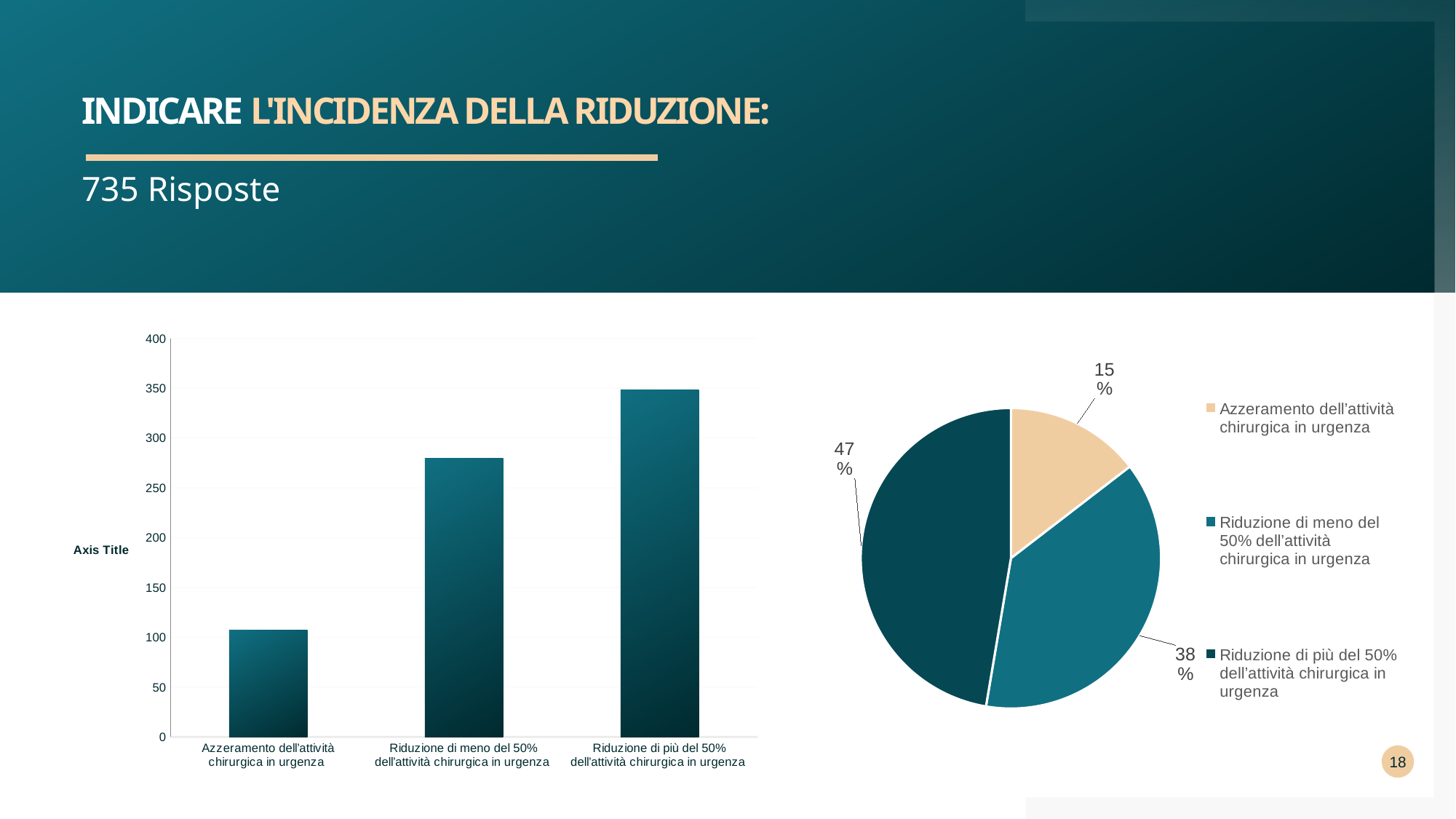
What kind of chart is on the right side of the slide? pie chart In the bar chart on the left, which category has the highest bar? Riduzione di più del 50% dell'attività chirurgica in urgenza What kind of chart is on the left side of the slide? bar chart In the pie chart on the right, what share is shown for Riduzione di più del 50% dell'attività chirurgica in urgenza? 47% In the pie chart on the right, how many percentage points larger is the 47% slice than the 38% slice? 9 In the bar chart on the left, how many categories are shown? 3 In the bar chart on the left, is the value for Riduzione di più del 50% dell'attività chirurgica in urgenza greater or less than 300? greater In the bar chart on the left, is the value for Azzeramento dell'attività chirurgica in urgenza greater or less than 150? less In the bar chart on the left, which category has the lowest bar? Azzeramento dell'attività chirurgica in urgenza In the pie chart on the right, what share is shown for Azzeramento dell'attività chirurgica in urgenza? 15% In the bar chart on the left, is the value for Riduzione di meno del 50% dell'attività chirurgica in urgenza greater or less than 250? greater In the bar chart on the left, do the bar values rise or fall from left to right? rise